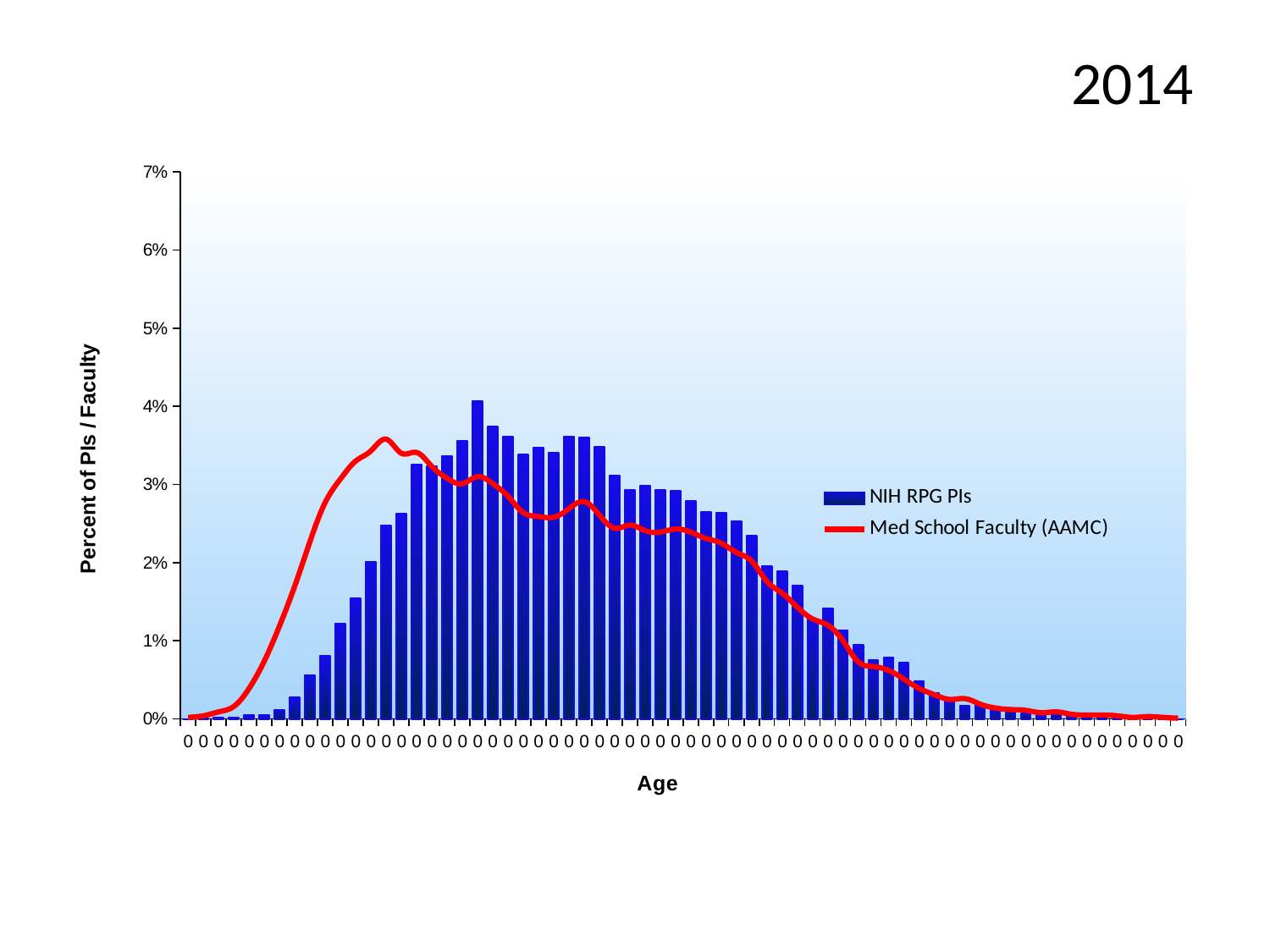
Is the tallest NIH RPG PIs bar greater or less than 4%? greater What kind of chart is shown on the slide? A bar chart with an overlaid line series Toward the right end of the Age axis, do the NIH RPG PIs bars rise or fall? fall Which series reaches the higher peak value, NIH RPG PIs or Med School Faculty (AAMC)? NIH RPG PIs Is the value of the Med School Faculty (AAMC) line at the far right of the Age axis greater or less than 1%? less How many series does the legend list? 2 What is the highest value shown on the vertical axis? 7% Is the peak of the Med School Faculty (AAMC) line greater or less than 3%? greater What is the title of the vertical axis? Percent of PIs / Faculty What are the two series named in the legend? NIH RPG PIs and Med School Faculty (AAMC)